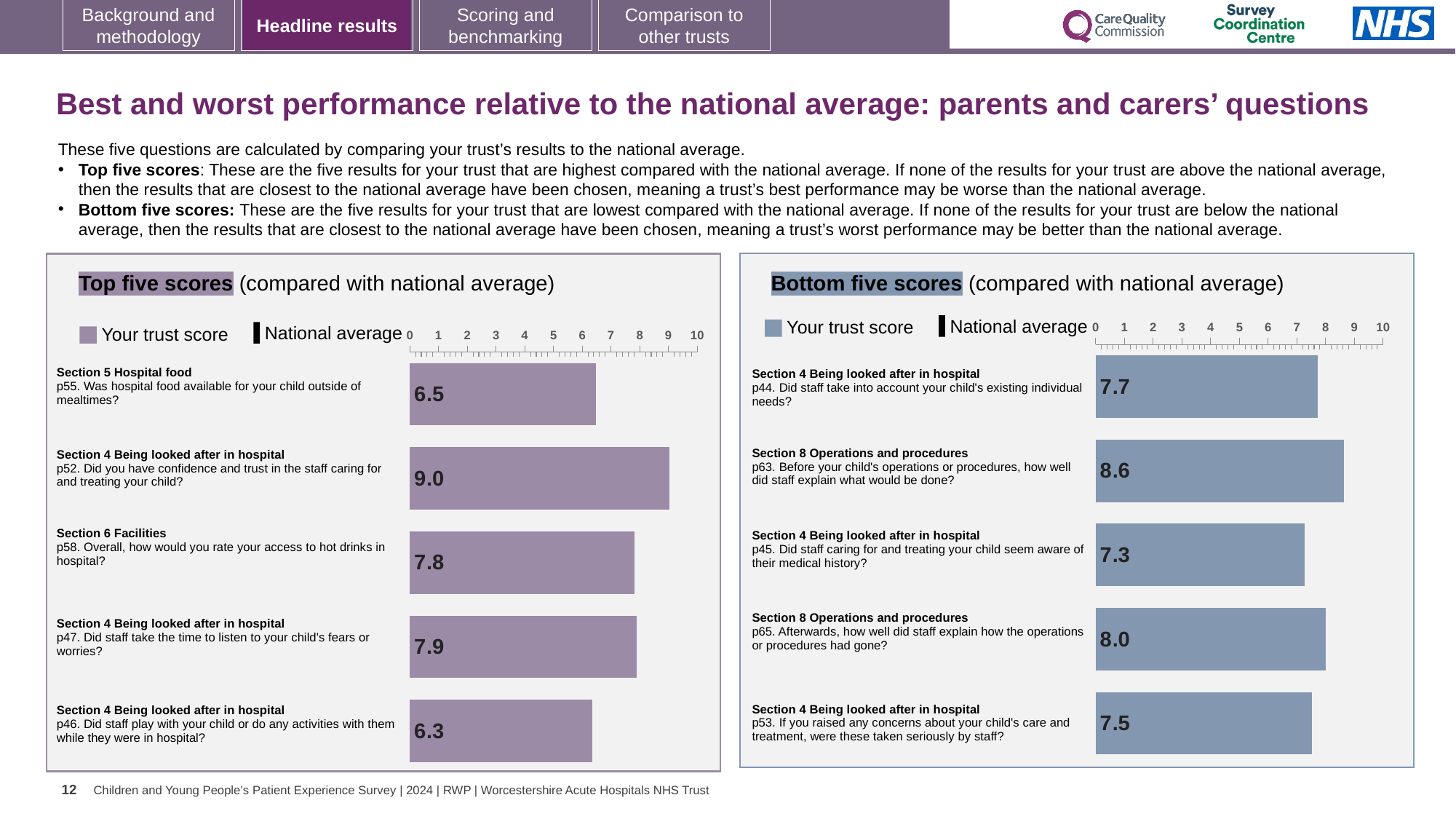
In the Top five scores chart, what is the trust score for p52 (Did you have confidence and trust in the staff caring for and treating your child?)? 9.0 In the Bottom five scores chart, which has the larger trust score: p44 or p65? p65 In the Bottom five scores chart, what is the difference between the scores for p63 and p45? 1.3 In the Top five scores chart, which question has the highest trust score? p52. Did you have confidence and trust in the staff caring for and treating your child? In the Bottom five scores chart, what is the trust score for p53 (If you raised any concerns about your child's care and treatment, were these taken seriously by staff?)? 7.5 In the Top five scores chart, what is the trust score for p46 (Did staff play with your child or do any activities with them while they were in hospital?)? 6.3 How many questions are shown in the Bottom five scores chart? 5 In the Bottom five scores chart, what is the trust score for p63 (Before your child's operations or procedures, how well did staff explain what would be done?)? 8.6 In the Bottom five scores chart, which question has the lowest trust score? p45. Did staff caring for and treating your child seem aware of their medical history? How many series does the legend of the Top five scores chart list? 2 In the Top five scores chart, what is the difference between the highest score (p52) and the lowest score (p46)? 2.7 What kind of chart is the Top five scores chart? Bar chart